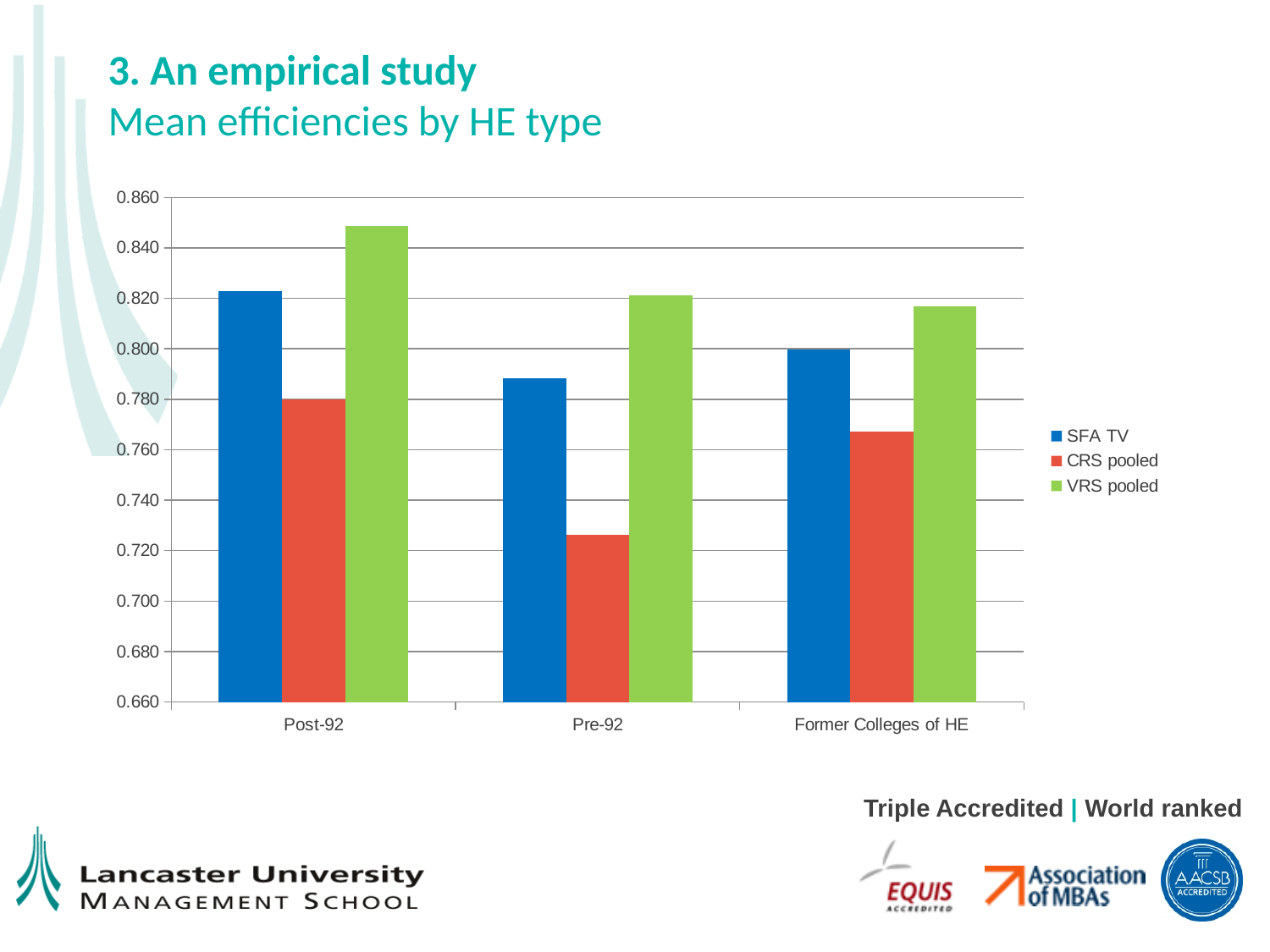
How many HE type categories are shown on the x axis? 3 Which HE type has the lowest CRS pooled mean efficiency? Pre-92 What is the title of the chart? Mean efficiencies by HE type Which series has the highest bar in every HE type category? VRS pooled Which HE type has the highest VRS pooled mean efficiency? Post-92 Which is larger, the SFA TV value for Post-92 or the SFA TV value for Pre-92? Post-92 Is the SFA TV value for Pre-92 greater or less than 0.800? less What kind of chart is shown on the slide? bar chart Is the CRS pooled value for Pre-92 greater or less than 0.740? less How many series does the legend list? 3 Is the SFA TV value for Post-92 greater or less than 0.800? greater